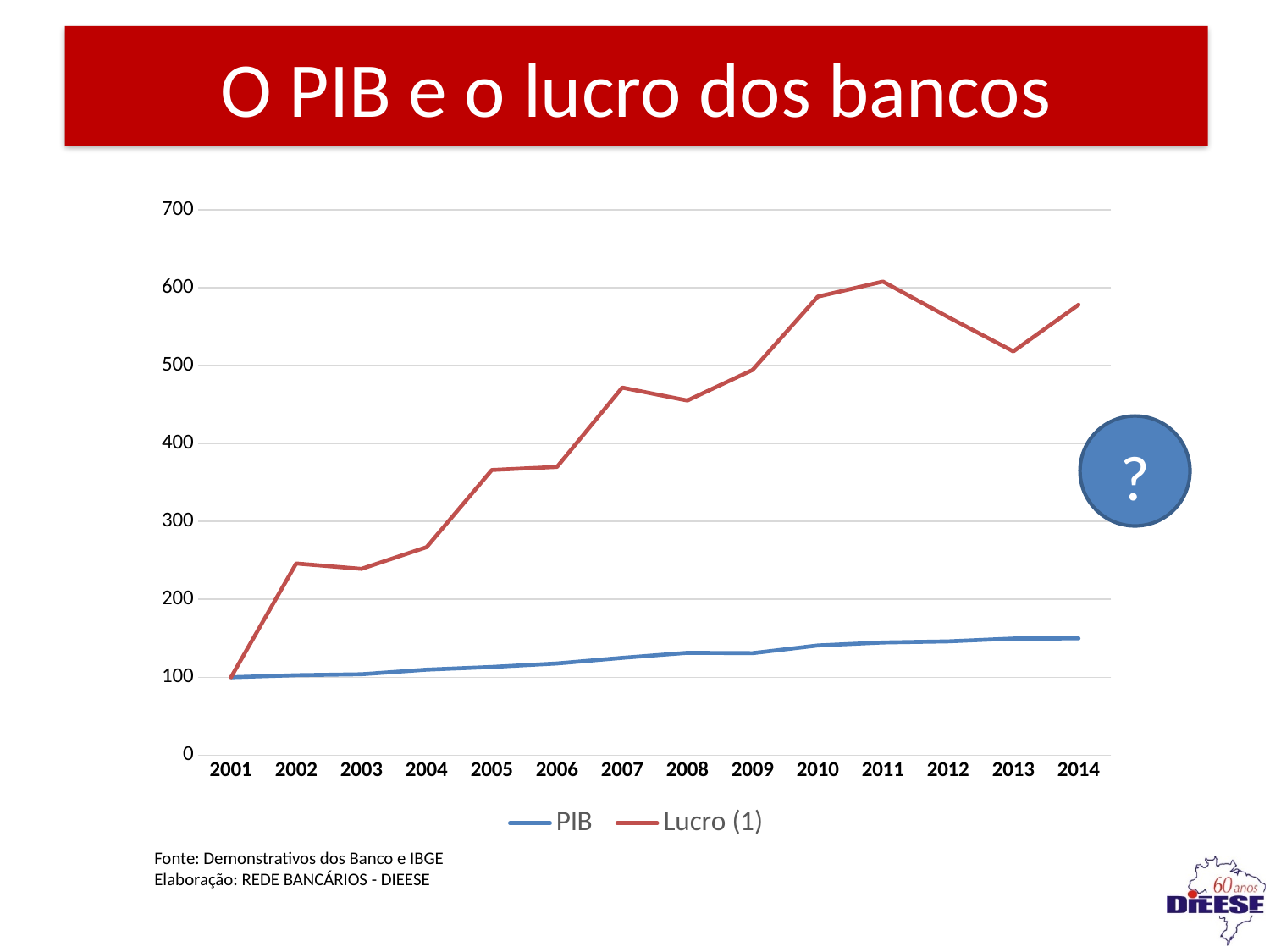
Is the value for Lucro (1) in 2013 greater or less than 600? less Is the value for PIB in 2014 greater or less than 200? less Which series has the higher value in 2014, PIB or Lucro (1)? Lucro (1) How many series does the legend list? 2 Does the PIB series generally rise or fall from 2001 to 2014? rise How many years are shown on the x axis? 14 What kind of chart is shown on the slide? line chart Is the value for Lucro (1) in 2010 greater or less than 500? greater In which year does the Lucro (1) series reach its highest value? 2011 What is the title of the slide? O PIB e o lucro dos bancos In which year is the Lucro (1) series at its lowest value? 2001 What is the value of the PIB series in 2001? 100